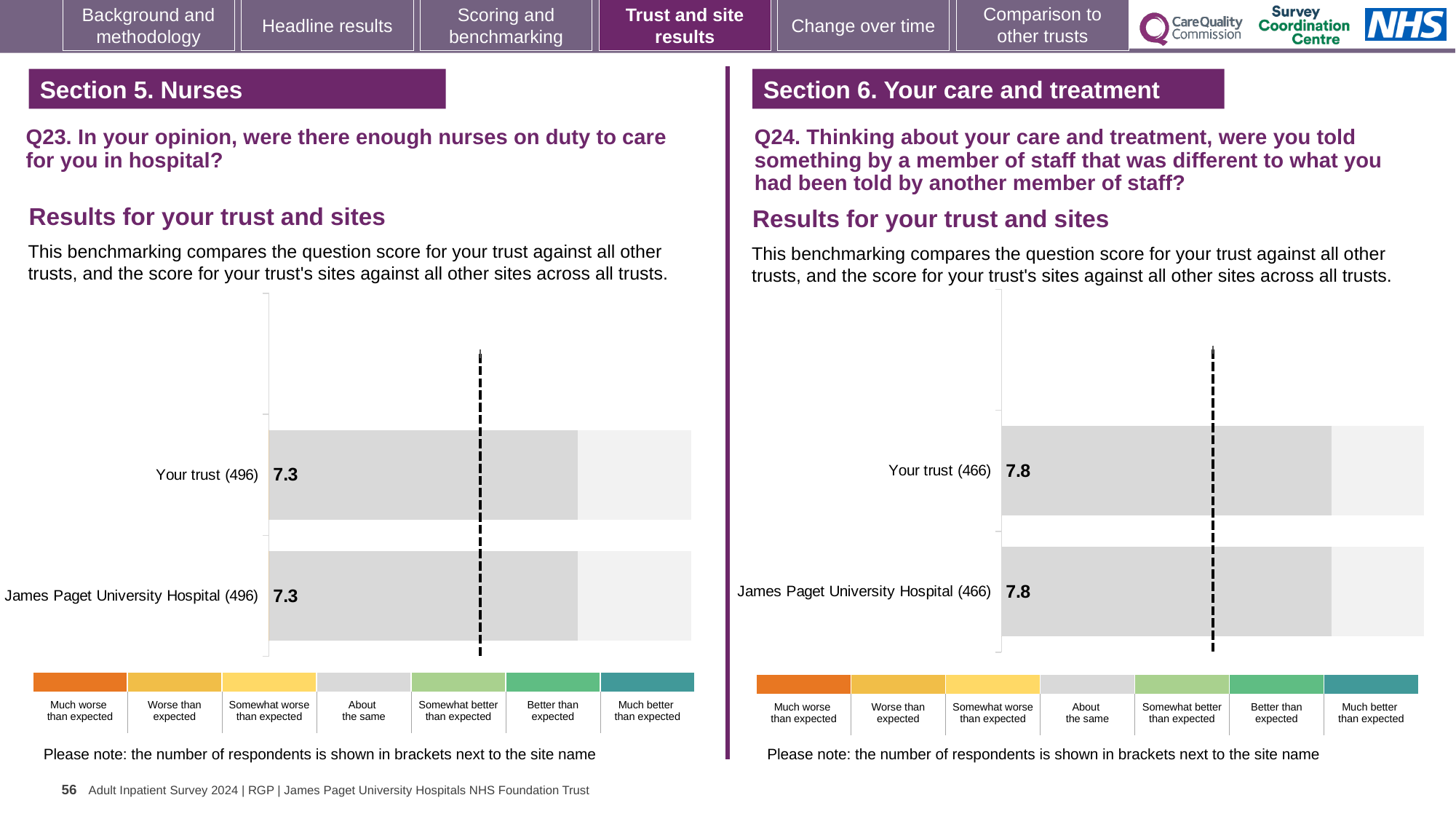
How many bars are plotted on the Q23 chart (left)? 2 How many bars are plotted on the Q24 chart (right)? 2 On the Q24 chart (right), how many respondents are shown in brackets for James Paget University Hospital? 466 What kind of chart is used on the Q23 chart (left)? Bar chart On the Q24 chart (right), what is the score for James Paget University Hospital? 7.8 On the Q23 chart (left), how many respondents are shown in brackets for Your trust? 496 On the Q24 chart (right), what is the score for Your trust? 7.8 On the Q23 chart (left), what is the score for James Paget University Hospital? 7.3 On the Q24 chart (right), what is the difference between the score for Your trust and the score for James Paget University Hospital? 0 On the Q23 chart (left), what is the score for Your trust? 7.3 How many categories does the colour key below the Q24 chart (right) list? 7 On the Q23 chart (left), what is the difference between the score for Your trust and the score for James Paget University Hospital? 0